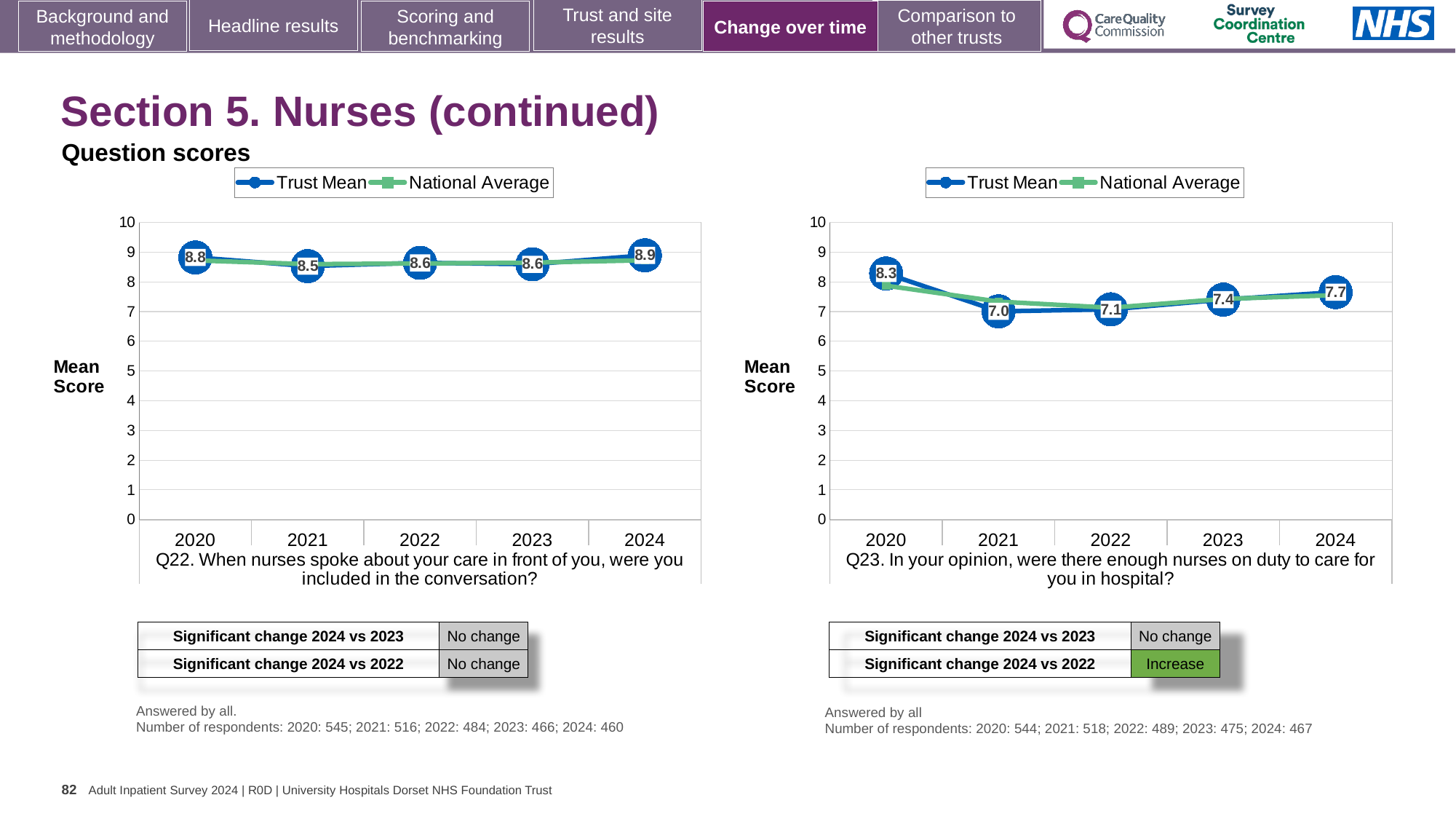
What type of chart is used for Q22 (left)? Line chart What does the table below the Q23 chart (right) show for significant change 2024 vs 2022? Increase On the Q23 chart (right), is the National Average for 2020 greater or less than 7? greater On the Q22 chart (left), what is the Trust Mean score for 2024? 8.9 On the Q23 chart (right), what is the difference between the Trust Mean scores for 2020 and 2021? 1.3 On the Q22 chart (left), is the Trust Mean score higher in 2020 or in 2021? 2020 On the Q23 chart (right), what is the Trust Mean score for 2021? 7.0 On the Q23 chart (right), which year has the highest Trust Mean score? 2020 On the Q22 chart (left), which year has the lowest Trust Mean score? 2021 On the Q23 chart (right), does the Trust Mean rise or fall from 2021 to 2024? Rise How many years are plotted on the Q22 chart (left)? 5 How many series does the legend of the Q23 chart (right) list? 2